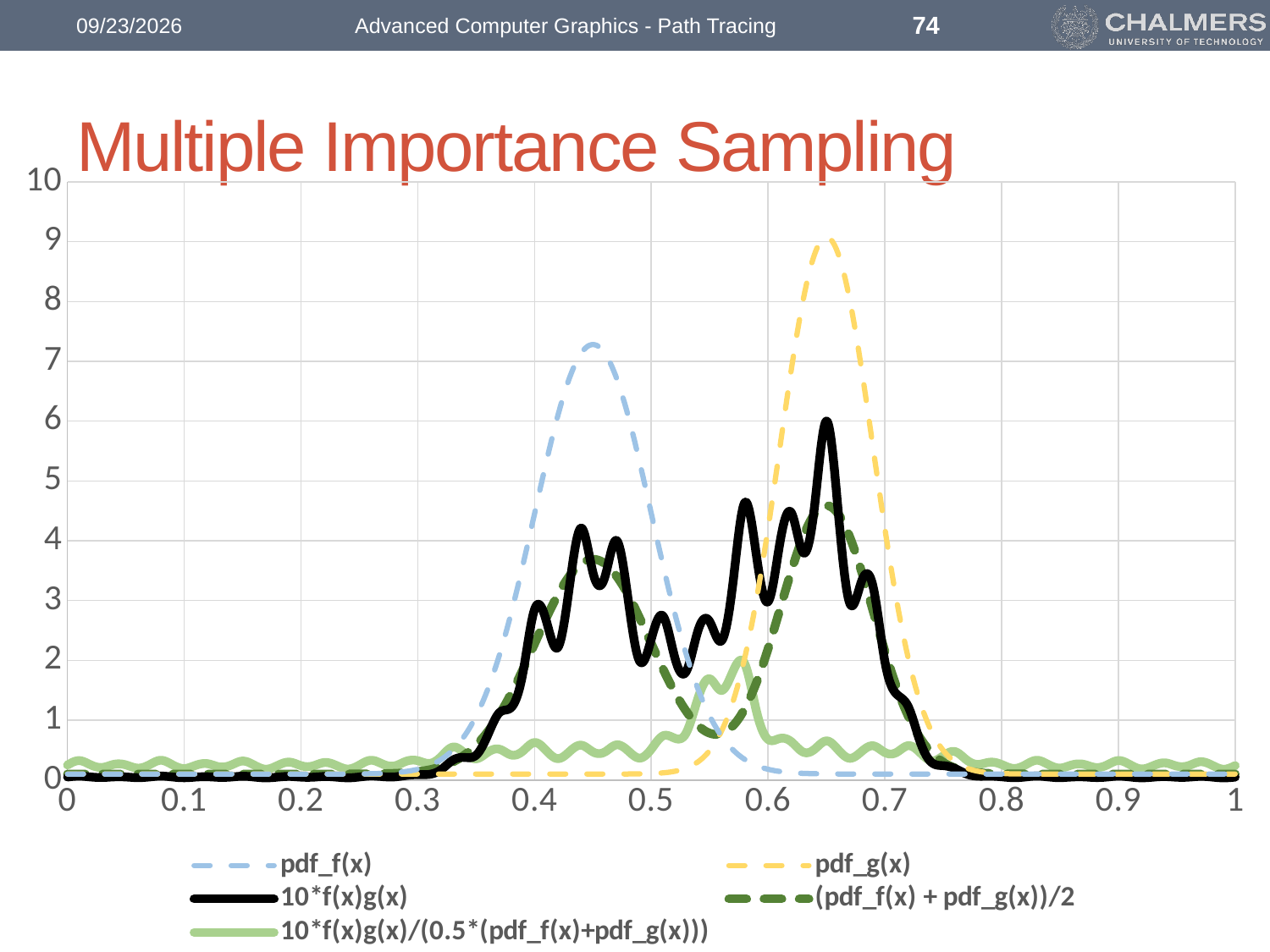
Is the peak value of pdf_g(x) greater or less than 8? greater Which series has a higher peak, 10*f(x)g(x) or (pdf_f(x) + pdf_g(x))/2? 10*f(x)g(x) Is the peak value of 10*f(x)g(x) greater or less than 7? less How many series does the legend list? 5 What is the maximum value shown on the y axis? 10 What is the title of the slide containing the chart? Multiple Importance Sampling Is the value of pdf_f(x) at x = 0.2 greater or less than 1? less Which series has a higher peak, pdf_f(x) or pdf_g(x)? pdf_g(x) What kind of chart is shown on the slide? line chart Which series reaches the highest peak on the chart? pdf_g(x)